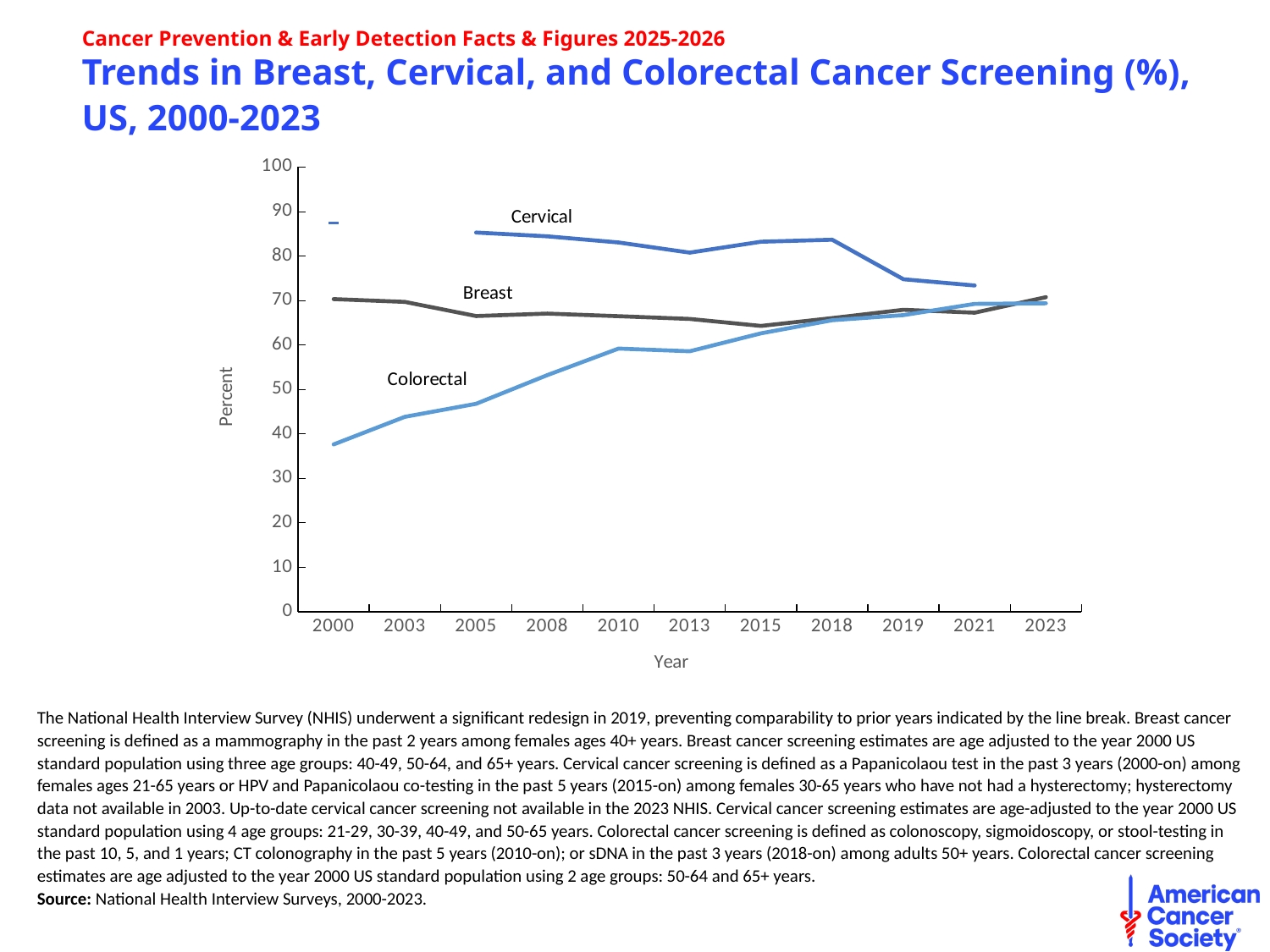
How many screening series are plotted on the chart? 3 How many years are marked on the x axis of the chart? 11 What is the label on the y axis of the chart? Percent What kind of chart is shown on the slide? line chart Is the value for Colorectal screening in 2005 greater or less than 50? less Which screening series has the lowest value in 2000? Colorectal Which screening series has the highest value in 2010? Cervical Is the value for Cervical screening in 2005 greater or less than 80? greater Is the value for Colorectal screening in 2000 greater or less than 40? less Does the Colorectal screening line rise or fall from 2000 to 2023? rise In 2005, which is larger: the Breast screening value or the Colorectal screening value? Breast